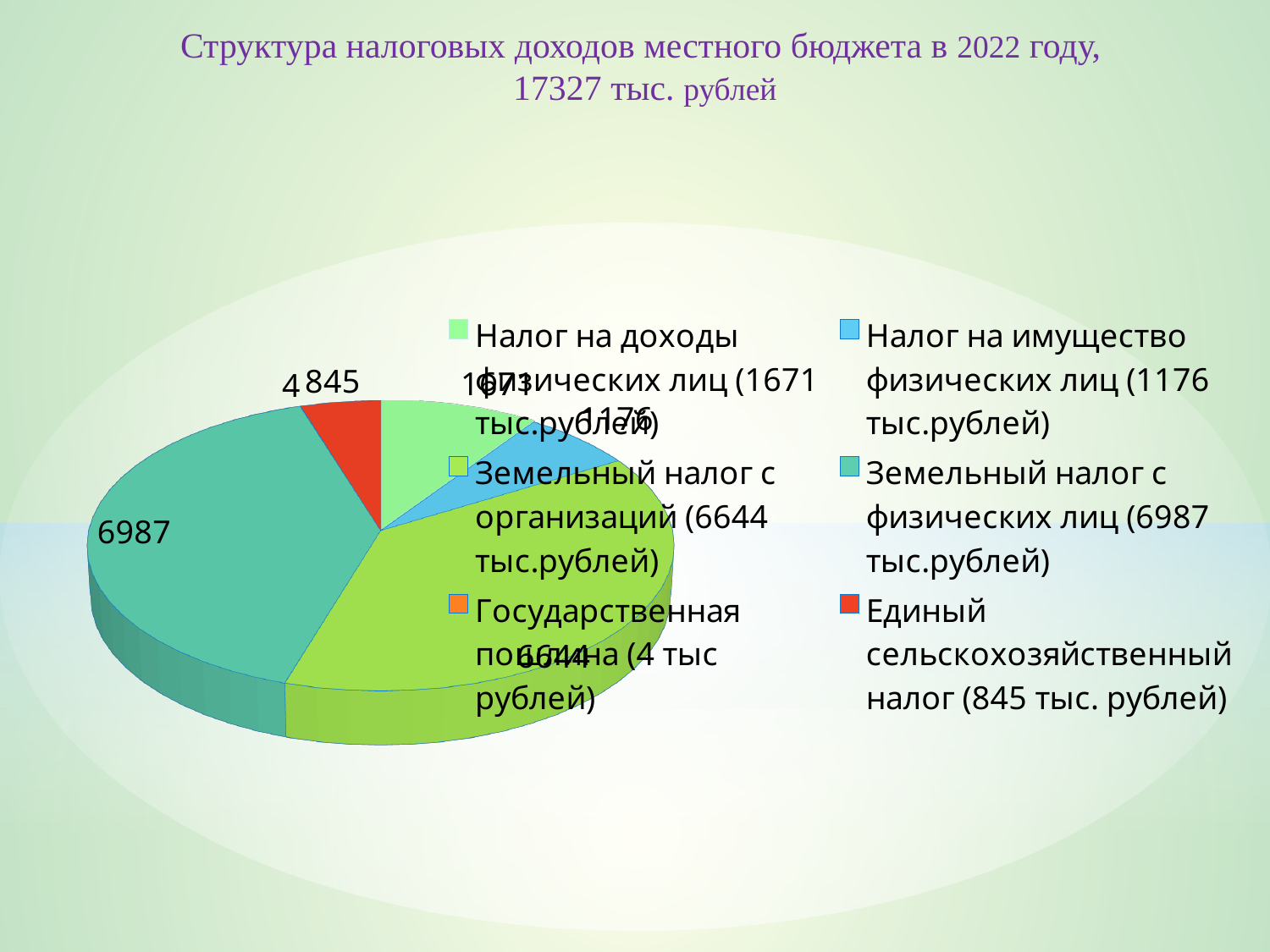
What is the value for Земельный налог с физических лиц? 6987 What is the value for Государственная пошлина? 4 What kind of chart is shown on the slide? Pie chart What is the difference between Налог на доходы физических лиц and Налог на имущество физических лиц? 495 What is the difference between Земельный налог с физических лиц and Земельный налог с организаций? 343 What is the value for Единый сельскохозяйственный налог? 845 Which category has the largest slice of the pie? Земельный налог с физических лиц How many categories are shown in the pie chart? 6 What is the value for Налог на имущество физических лиц? 1176 Which category has the smallest slice of the pie? Государственная пошлина What total amount in тыс. рублей is stated in the chart title? 17327 Which is larger: Налог на доходы физических лиц or Единый сельскохозяйственный налог? Налог на доходы физических лиц